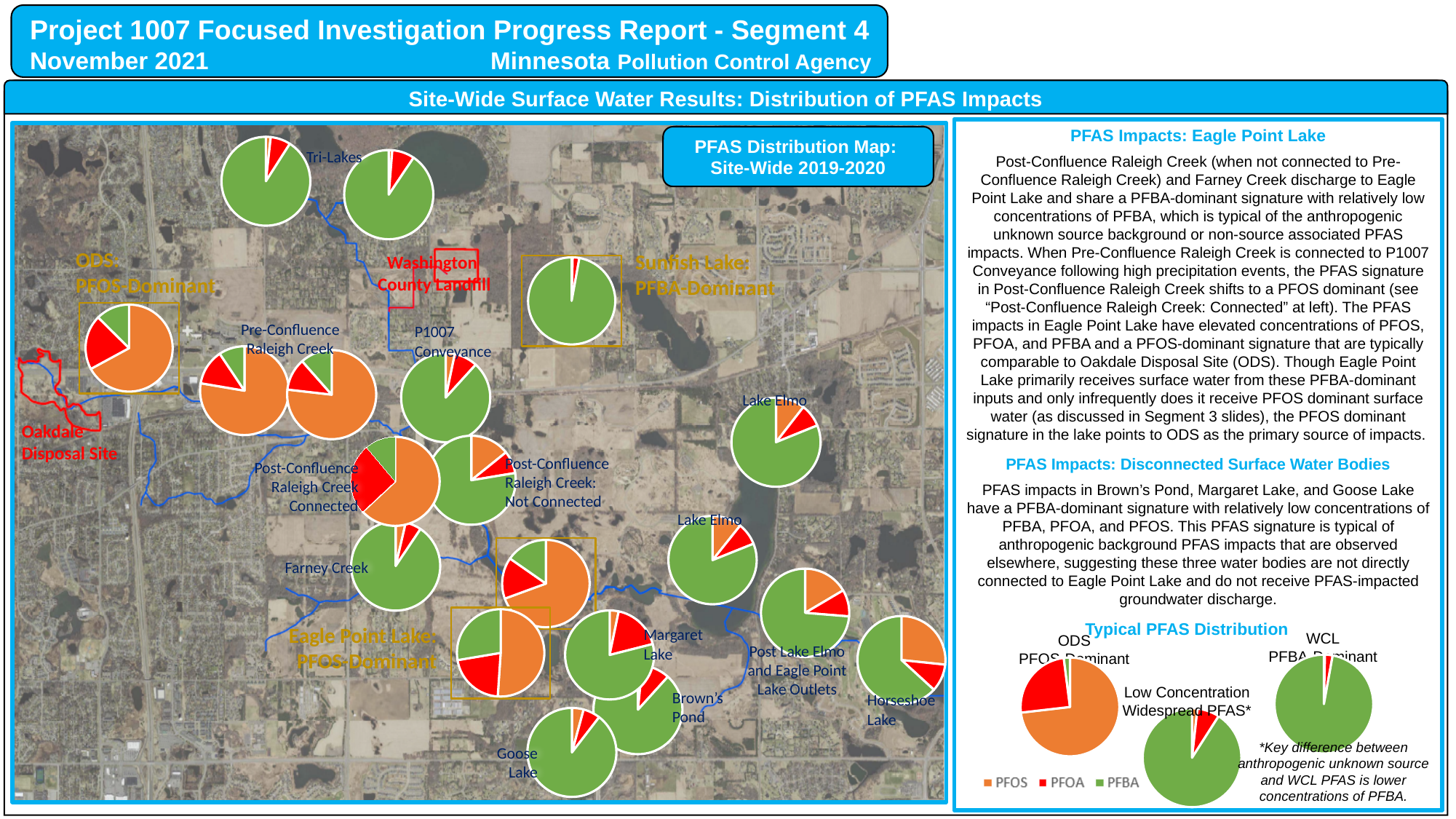
What kind of chart is used to show the PFAS distribution at each location on the map? Pie chart What is the title of the map inset containing the pie charts? PFAS Distribution Map: Site-Wide 2019-2020 How many compounds does the legend under the Typical PFAS Distribution charts list? 3 In the Typical PFAS Distribution section, which compound has the largest share in the WCL PFBA-Dominant pie? PFBA On the map, in the Lake Elmo pie, which is larger: the PFBA share or the PFOS share? PFBA How many pie charts are shown in the Typical PFAS Distribution section? 3 On the map, in the Post-Confluence Raleigh Creek Connected pie, which is larger: the PFOS share or the PFBA share? PFOS Which compounds are listed in the legend of the Typical PFAS Distribution charts? PFOS, PFOA, PFBA On the map, which compound has the largest share in the Pre-Confluence Raleigh Creek pies? PFOS In the Typical PFAS Distribution section, which compound has the largest share in the Low Concentration Widespread PFAS pie? PFBA